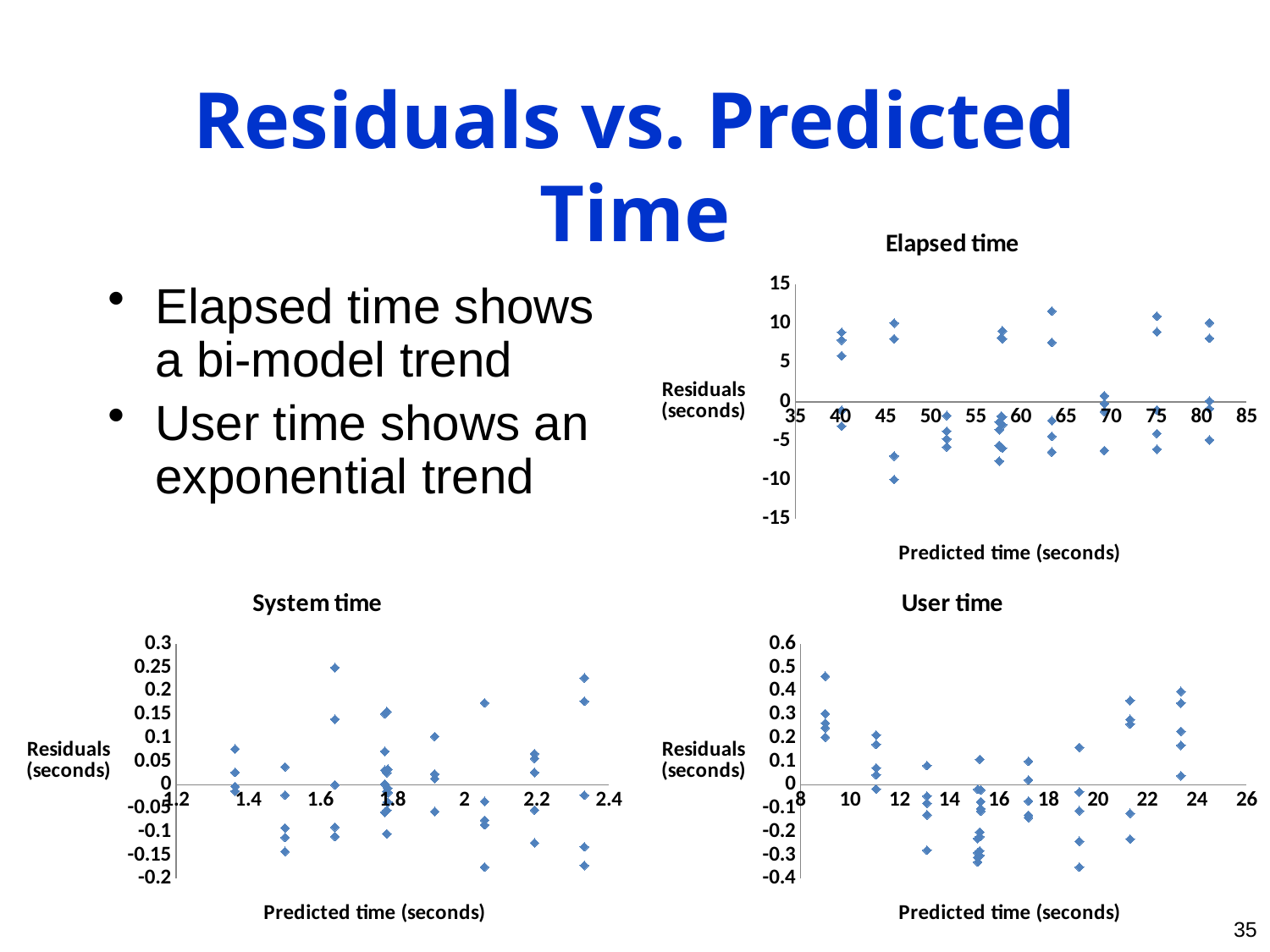
What kind of chart is the 'System time' chart? scatter chart What kind of chart is the 'Elapsed time' chart? scatter chart What is the x-axis title of the 'User time' chart? Predicted time (seconds) In the 'User time' chart, is the lowest residual value greater or less than -0.3? less In the 'System time' chart, is the lowest residual value greater or less than -0.15? less In the 'User time' chart, is the highest residual value greater or less than 0.4? greater What is the y-axis title of the 'System time' chart? Residuals (seconds) How many charts are shown on the slide? 3 What kind of chart is the 'User time' chart? scatter chart